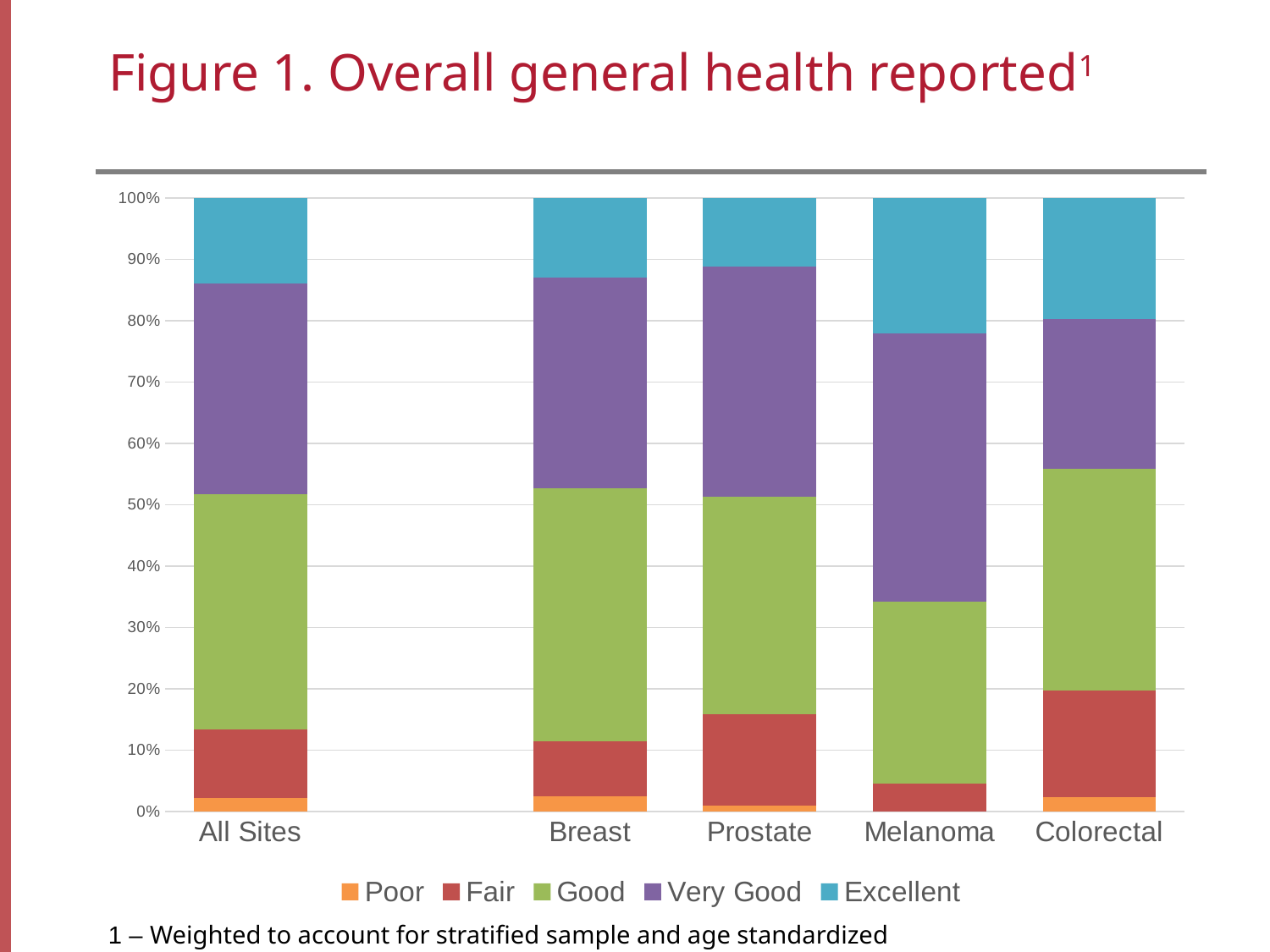
How many series does the legend list? 5 Which category has the smallest Fair segment? Melanoma Is the Fair segment for Melanoma greater or less than 10%? less What is the total of the stacked bar for Breast? 100% Which category has the largest Excellent segment? Melanoma Which series is listed first in the legend? Poor How many categories are shown on the x axis of the chart? 5 Is the Good segment larger for Breast or for Melanoma? Breast What kind of chart is shown on the slide? Stacked bar chart Which category has the largest Very Good segment? Melanoma Is the Very Good segment for Melanoma greater or less than 40%? greater Which category has the smallest Very Good segment? Colorectal